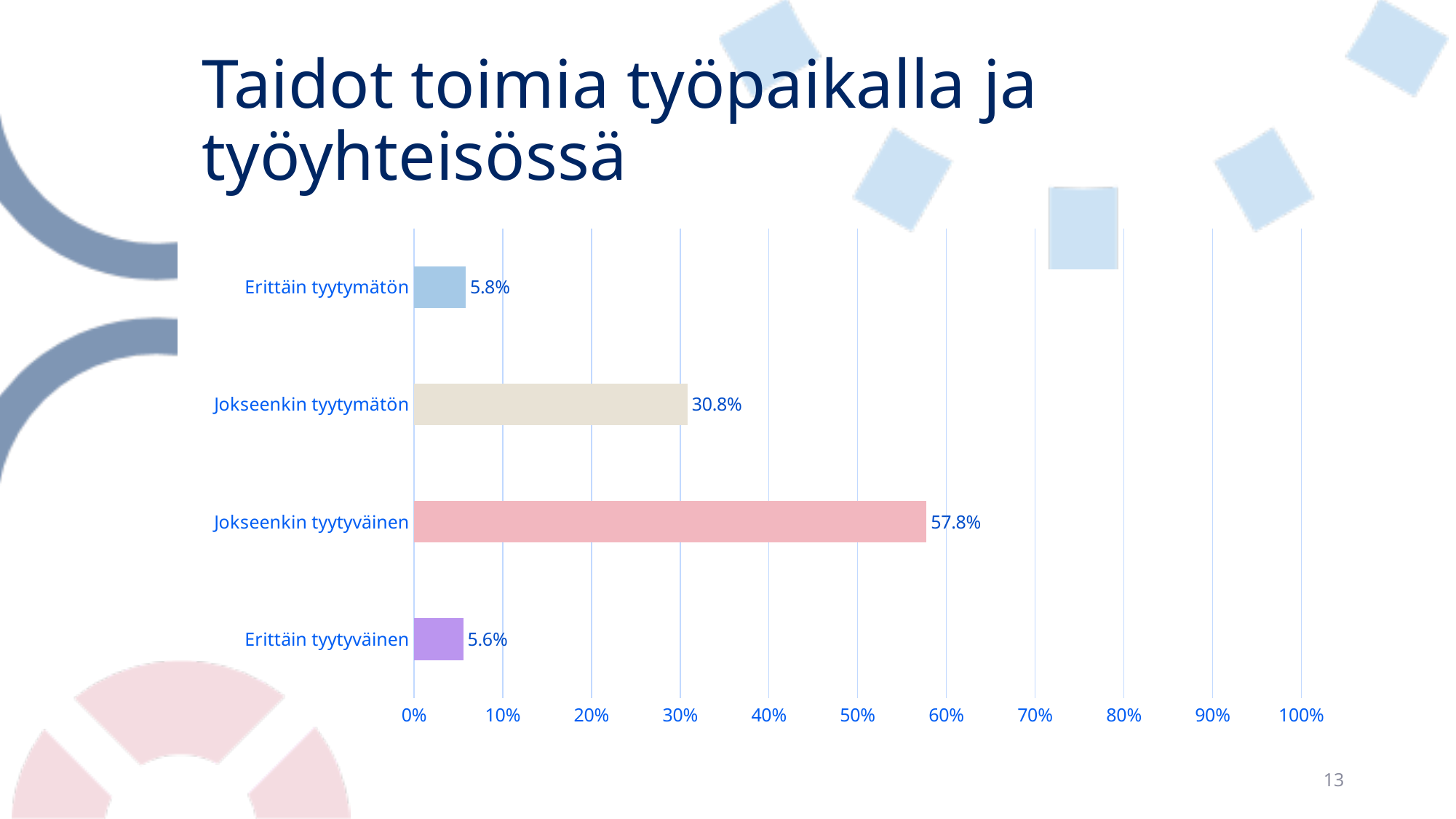
How many categories are shown in the chart? 4 What is the value for Erittäin tyytyväinen? 5.6% What is the difference between the values for Erittäin tyytymätön and Erittäin tyytyväinen? 0.2% What is the value for Jokseenkin tyytymätön? 30.8% What kind of chart is shown on the slide? bar chart What is the value for Erittäin tyytymätön? 5.8% Which is larger, the value for Jokseenkin tyytymätön or the value for Erittäin tyytymätön? Jokseenkin tyytymätön What is the difference between the values for Jokseenkin tyytyväinen and Jokseenkin tyytymätön? 27.0% What is the value for Jokseenkin tyytyväinen? 57.8% What is the title of the slide? Taidot toimia työpaikalla ja työyhteisössä Is the value for Jokseenkin tyytyväinen greater or less than 50%? greater Which category has the highest value? Jokseenkin tyytyväinen